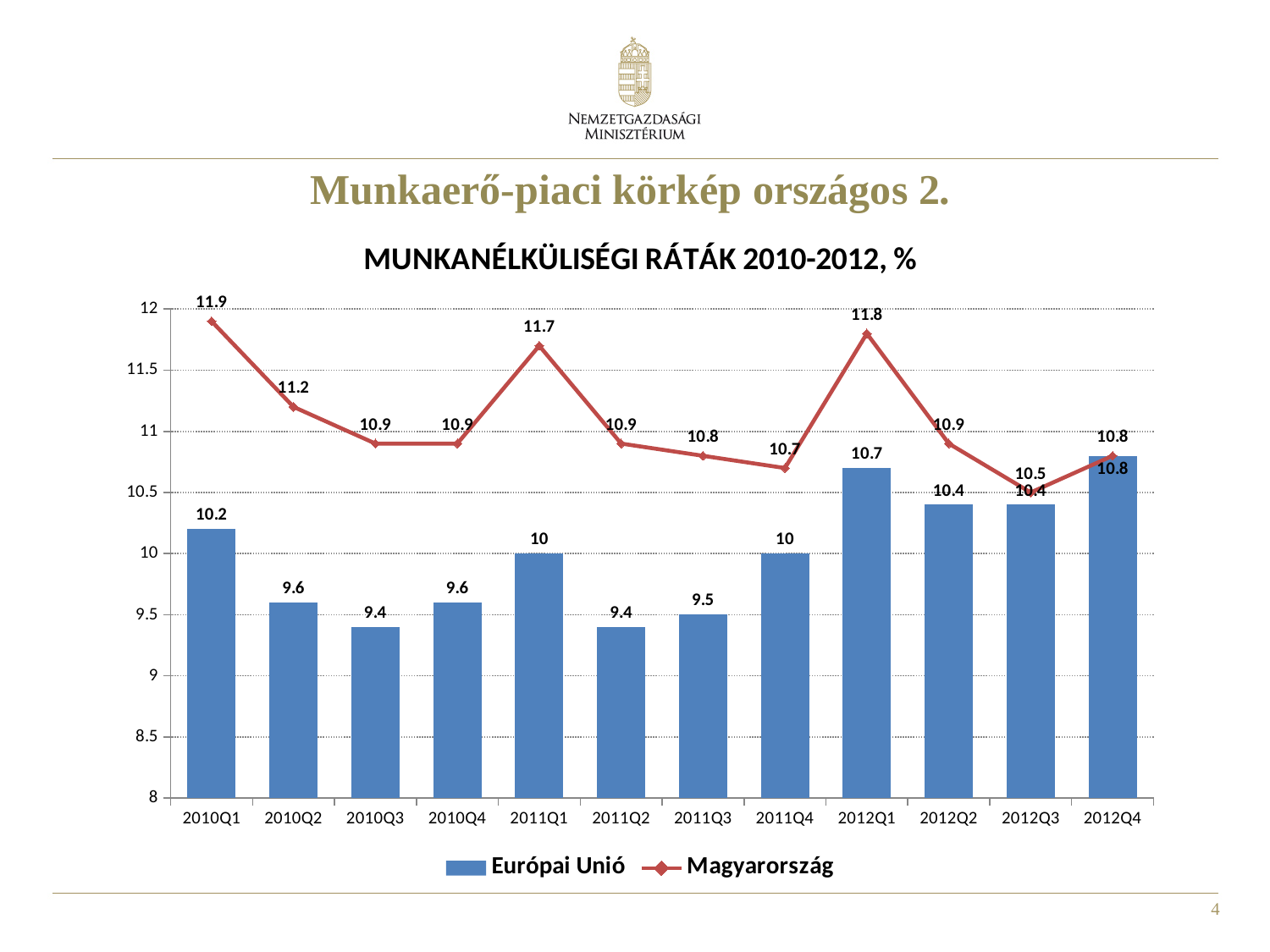
What is the Magyarország unemployment rate for 2011Q1? 11.7 What is the difference between the Magyarország and Európai Unió rates in 2010Q1? 1.7 What kind of chart is shown on the slide? Combined bar and line chart In which quarter is the Európai Unió rate highest? 2012Q4 How many quarters are shown on the x axis? 12 What is the Európai Unió value for 2012Q2? 10.4 How many series does the legend list? 2 Does the Magyarország rate rise or fall from 2012Q1 to 2012Q3? fall What is the Európai Unió unemployment rate for 2010Q1? 10.2 In 2012Q1, which series has the higher value, Európai Unió or Magyarország? Magyarország Is the Európai Unió value for 2012Q1 greater or less than 10.5? greater In which quarter is the Magyarország rate highest? 2010Q1